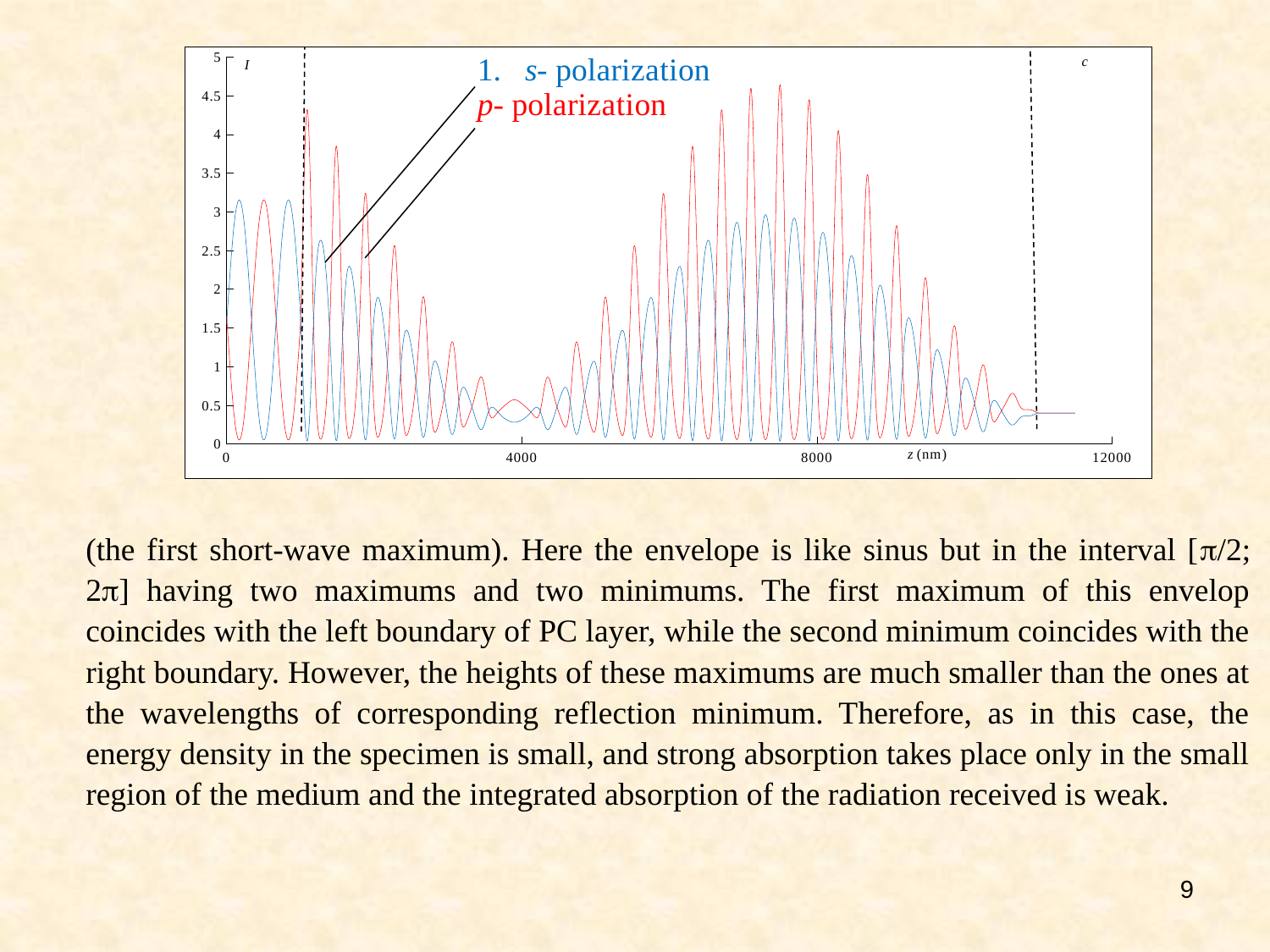
What is the maximum value shown on the x axis? 12000 Which colour is used for the p-polarization curve? red What is the maximum value shown on the y axis? 5 Is the highest peak of the s-polarization curve greater or less than 3? greater Which series reaches the higher peak value, s-polarization or p-polarization? p-polarization How many series does the chart's legend list? 2 Is the highest peak of the p-polarization curve greater or less than 4? greater What kind of chart is shown on the slide? line chart Is the highest peak of the p-polarization curve greater or less than 5? less